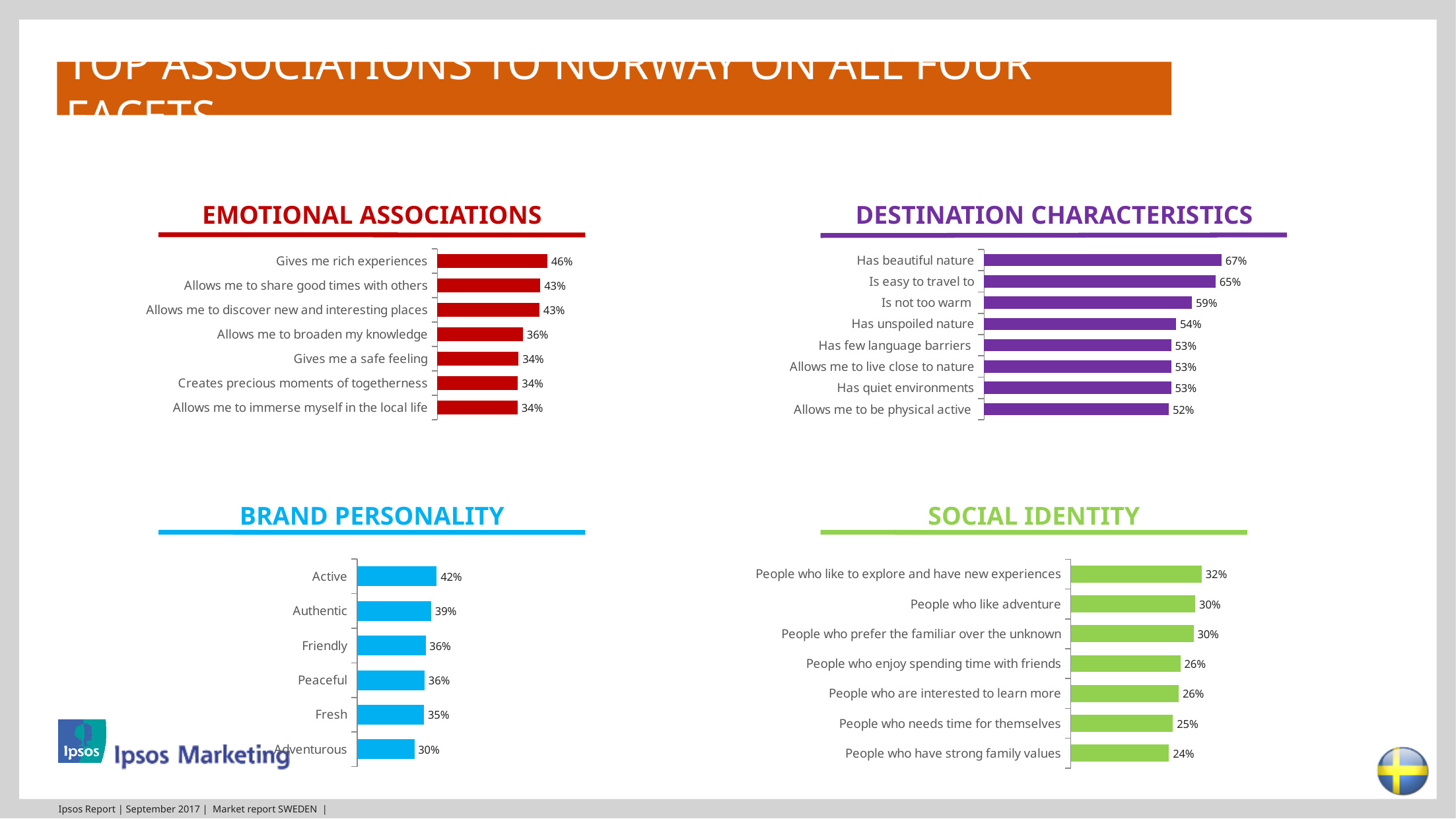
In the Emotional Associations chart, what is the value for "Gives me rich experiences"? 46% In the Destination Characteristics chart, what is the value for "Is not too warm"? 59% In the Destination Characteristics chart, what is the difference between "Has beautiful nature" and "Allows me to be physical active"? 15% In the Brand Personality chart, what is the difference between the values for Active and Authentic? 3% In the Destination Characteristics chart, which category has the highest value? Has beautiful nature In the Destination Characteristics chart, how many categories are shown? 8 What colour are the bars in the Social Identity chart? Green In the Social Identity chart, what is the value for "People who have strong family values"? 24% In the Brand Personality chart, which category has the lowest value? Adventurous What kind of chart is the Brand Personality chart? Bar chart In the Social Identity chart, how many categories are shown? 7 In the Emotional Associations chart, which is larger: "Allows me to broaden my knowledge" or "Gives me a safe feeling"? Allows me to broaden my knowledge